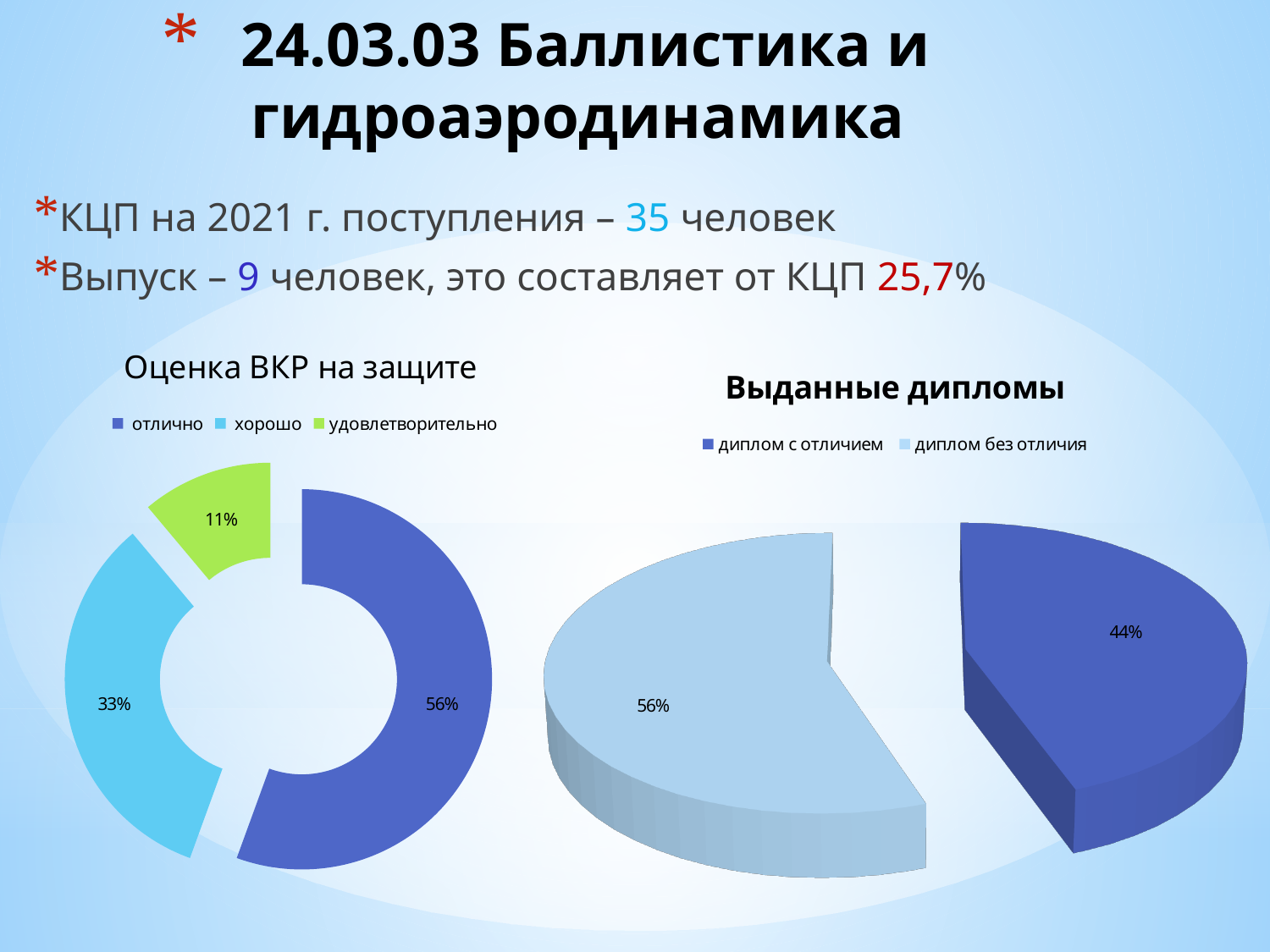
In the "Выданные дипломы" chart, how many categories does the legend list? 2 In the "Оценка ВКР на защите" chart, which category has the smallest share? удовлетворительно In the "Выданные дипломы" chart, what share is labelled for "диплом без отличия"? 56% In the "Оценка ВКР на защите" chart, which category has the largest share? отлично In the "Оценка ВКР на защите" chart, what share is labelled for "хорошо"? 33% In the "Выданные дипломы" chart, which category has the larger share: "диплом с отличием" or "диплом без отличия"? диплом без отличия What kind of chart is the "Выданные дипломы" chart? pie chart In the "Оценка ВКР на защите" chart, how many categories does the legend list? 3 In the "Оценка ВКР на защите" chart, what is the difference in percentage points between "отлично" and "хорошо"? 23 In the "Оценка ВКР на защите" chart, what share is labelled for "отлично"? 56% In the "Выданные дипломы" chart, what share is labelled for "диплом с отличием"? 44% In the "Оценка ВКР на защите" chart, what share is labelled for "удовлетворительно"? 11%